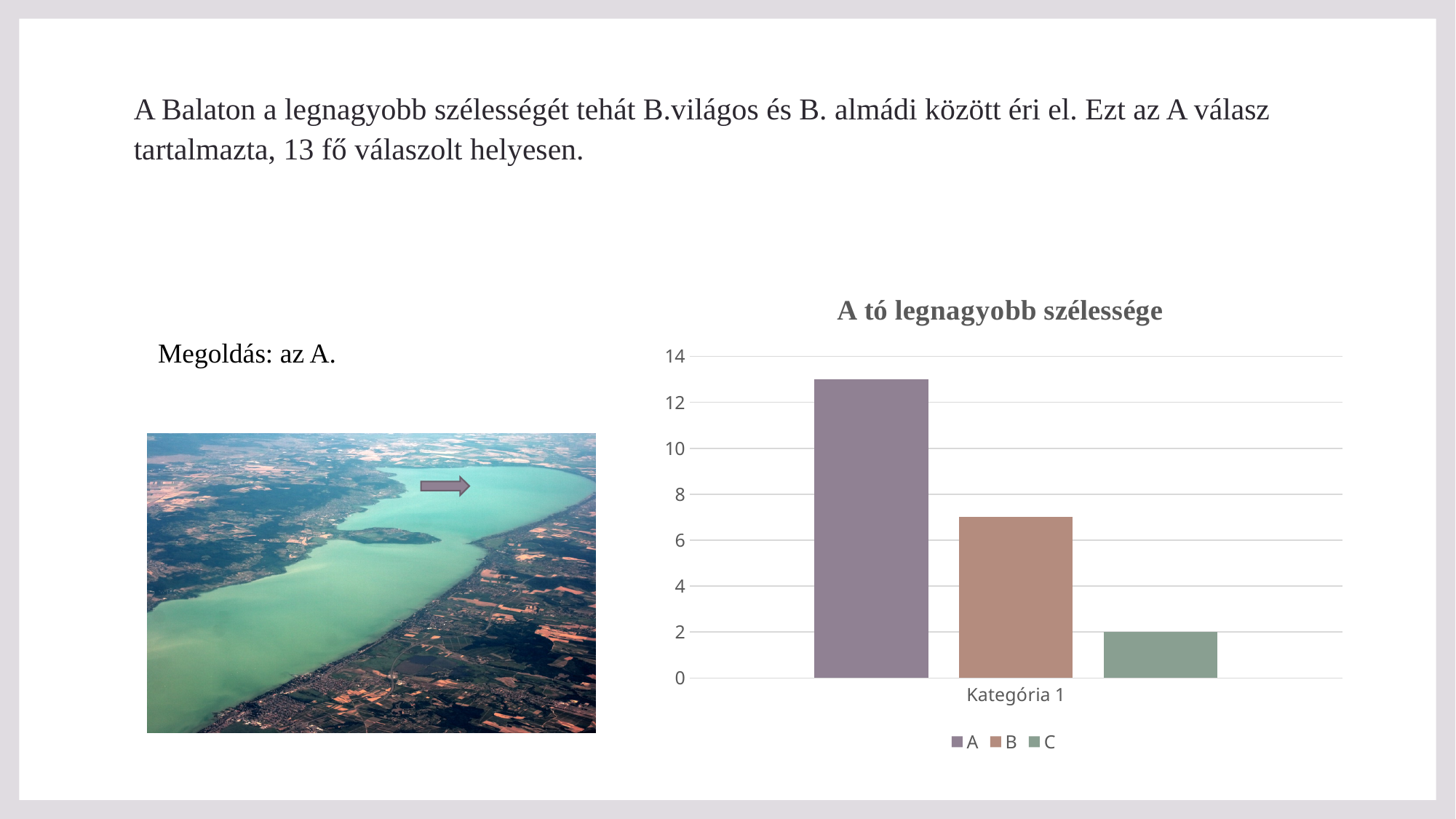
What is the value for series A in the chart? 13 Is the value for series B greater or less than 6? greater What type of chart is shown on the slide? bar chart How many categories are shown on the x axis of the chart? 1 What are the series names listed in the chart legend? A, B, C Which series has the highest value in the chart? A How many series does the chart legend list? 3 Is the value for series A greater or less than 12? greater What is the value for series C in the chart? 2 Which series has the lowest value in the chart? C Which is larger in the chart, the value for B or the value for C? B What is the title of the chart? A tó legnagyobb szélessége